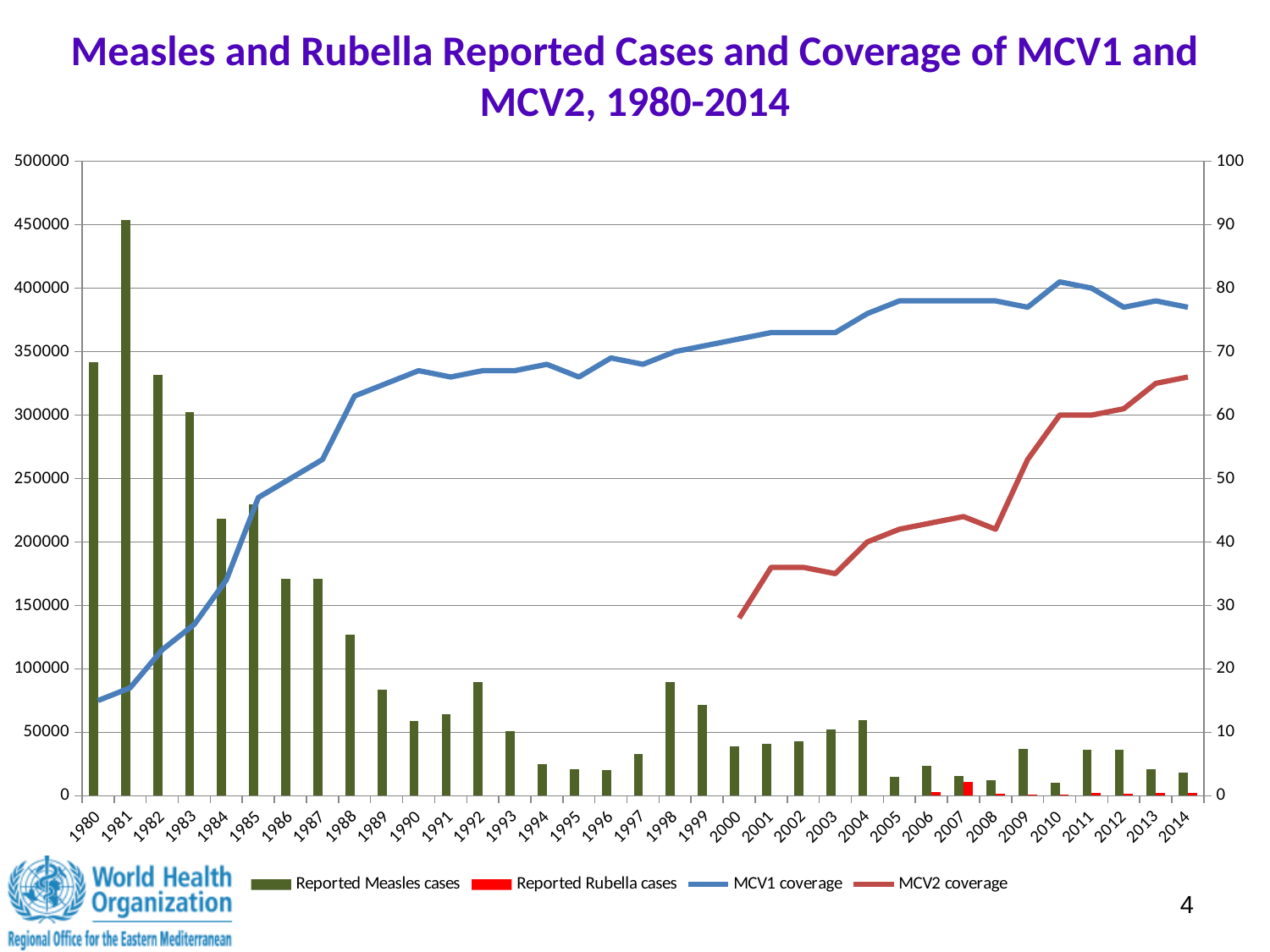
In which year were reported measles cases highest? 1981 Does MCV1 coverage generally rise or fall from 1980 to 2014? rise How many series does the legend list? 4 Is the MCV2 coverage in 2014 greater or less than 60? greater What kind of chart is this? Combination bar and line chart How many years are shown on the x axis? 35 Is the number of reported measles cases in 1980 greater or less than 300000? greater What is the title of the chart? Measles and Rubella Reported Cases and Coverage of MCV1 and MCV2, 1980-2014 Is the MCV1 coverage in 1980 greater or less than 20? less In which year is MCV2 coverage lowest? 2000 Which is higher in 2014, MCV1 coverage or MCV2 coverage? MCV1 coverage